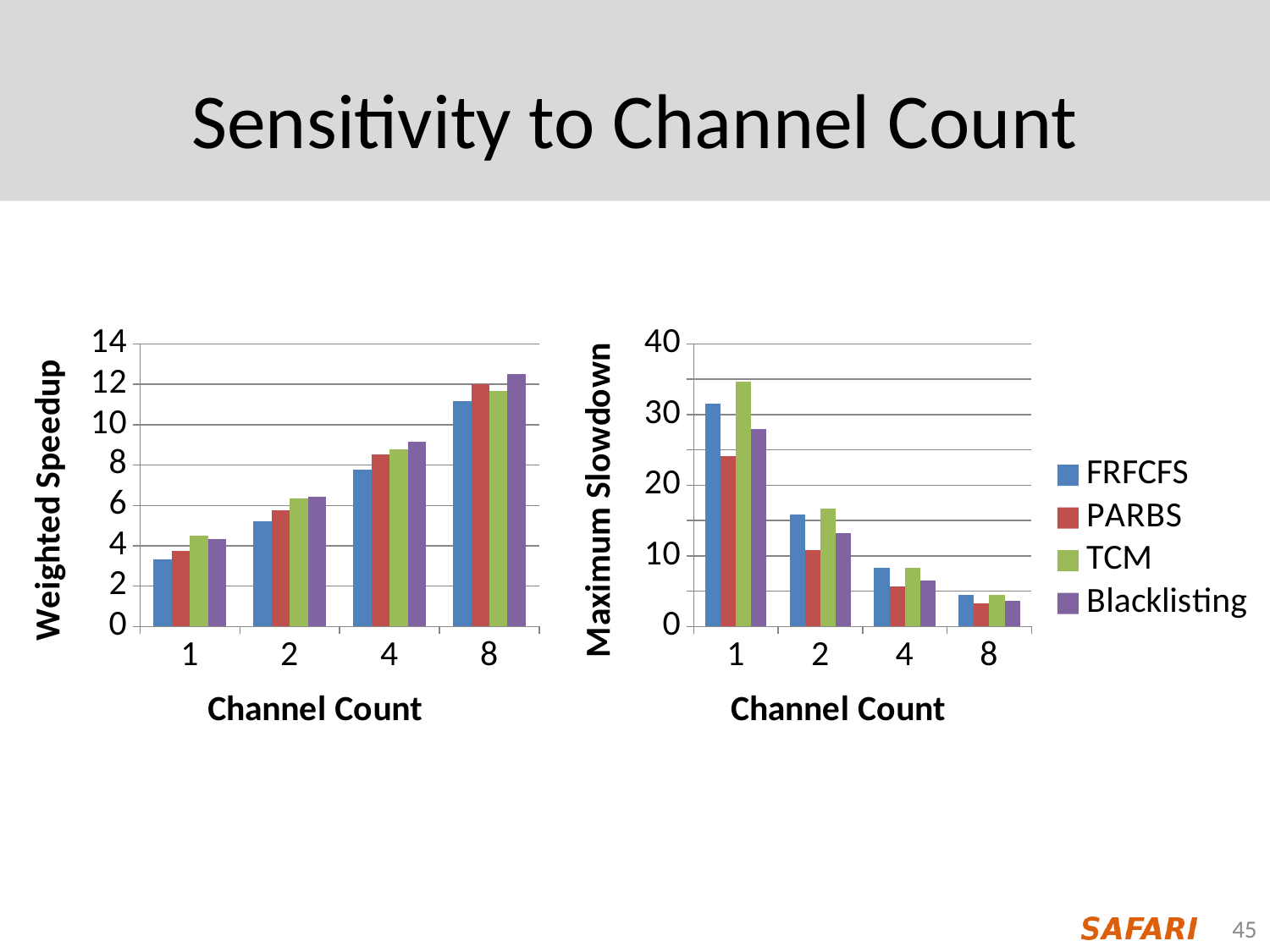
How many channel count categories are shown on the x axis of the right chart (Maximum Slowdown)? 4 How many series does the legend list? 4 In the right chart (Maximum Slowdown), does the TCM series rise or fall as channel count increases from 1 to 8? fall In the left chart (Weighted Speedup), is the value for Blacklisting at channel count 8 greater or less than 12? greater In the left chart (Weighted Speedup), is the value for FRFCFS at channel count 1 greater or less than 4? less What kind of chart is the left chart (Weighted Speedup)? bar chart In the right chart (Maximum Slowdown), which series has the highest value at channel count 1? TCM In the right chart (Maximum Slowdown), is the value for PARBS at channel count 2 greater or less than 20? less In the left chart (Weighted Speedup), which is larger at channel count 4: FRFCFS or Blacklisting? Blacklisting In the right chart (Maximum Slowdown), which series has the lowest value at channel count 1? PARBS In the left chart (Weighted Speedup), does the FRFCFS series rise or fall as channel count increases from 1 to 8? rise